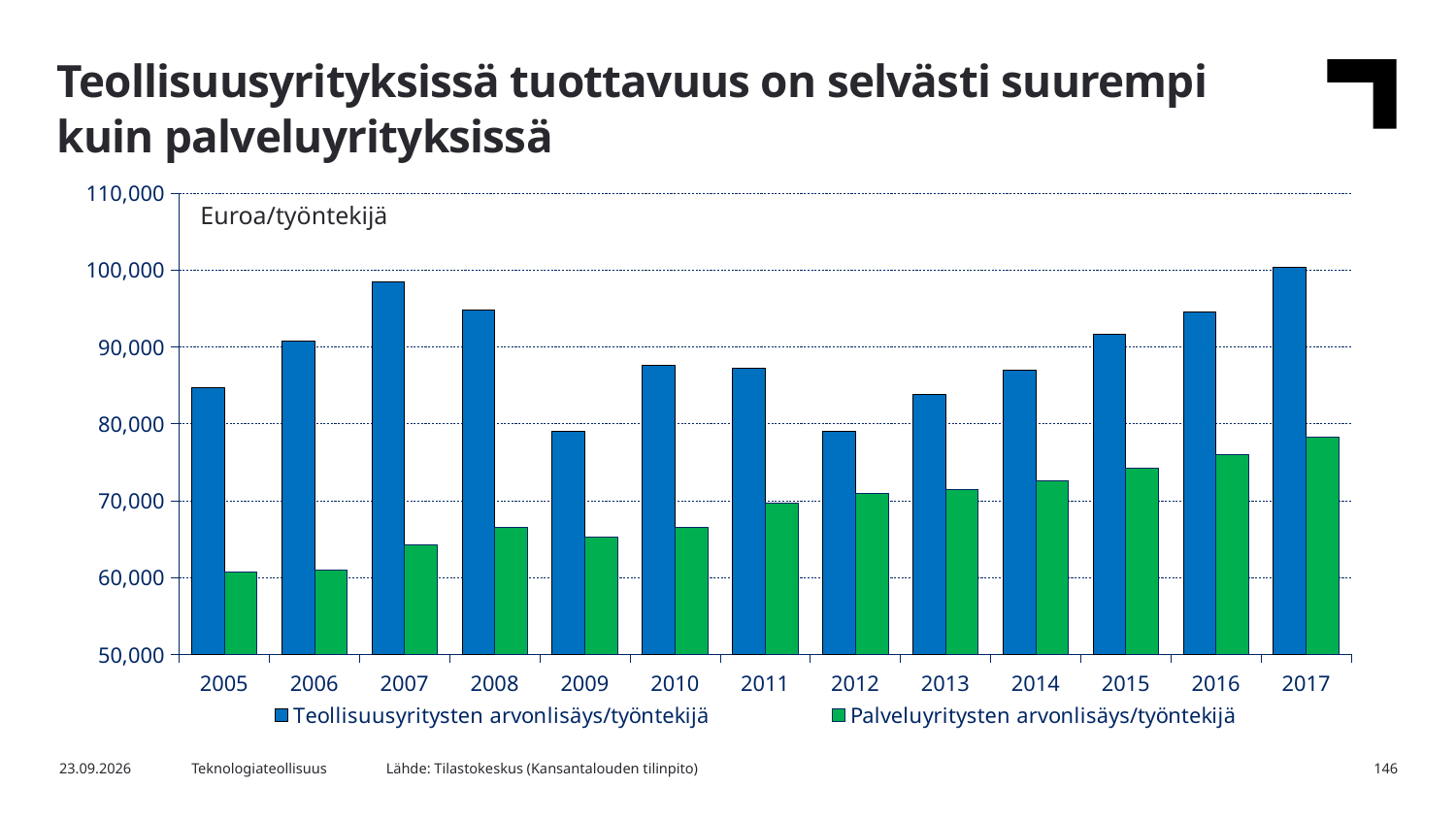
Which year has the highest value for Teollisuusyritysten arvonlisäys/työntekijä? 2017 Does the value for Palveluyritysten arvonlisäys/työntekijä generally rise or fall from 2005 to 2017? rise Is the value for Teollisuusyritysten arvonlisäys/työntekijä in 2009 greater or less than 80,000? less Which year has the highest value for Palveluyritysten arvonlisäys/työntekijä? 2017 What unit label is shown inside the chart area? Euroa/työntekijä How many series does the legend list? 2 Is the value for Palveluyritysten arvonlisäys/työntekijä in 2016 greater or less than 80,000? less Which is larger for Teollisuusyritysten arvonlisäys/työntekijä: the value in 2007 or in 2008? 2007 What kind of chart is shown on the slide? bar chart How many years are shown on the x axis? 13 Is the value for Palveluyritysten arvonlisäys/työntekijä in 2005 greater or less than 60,000? greater